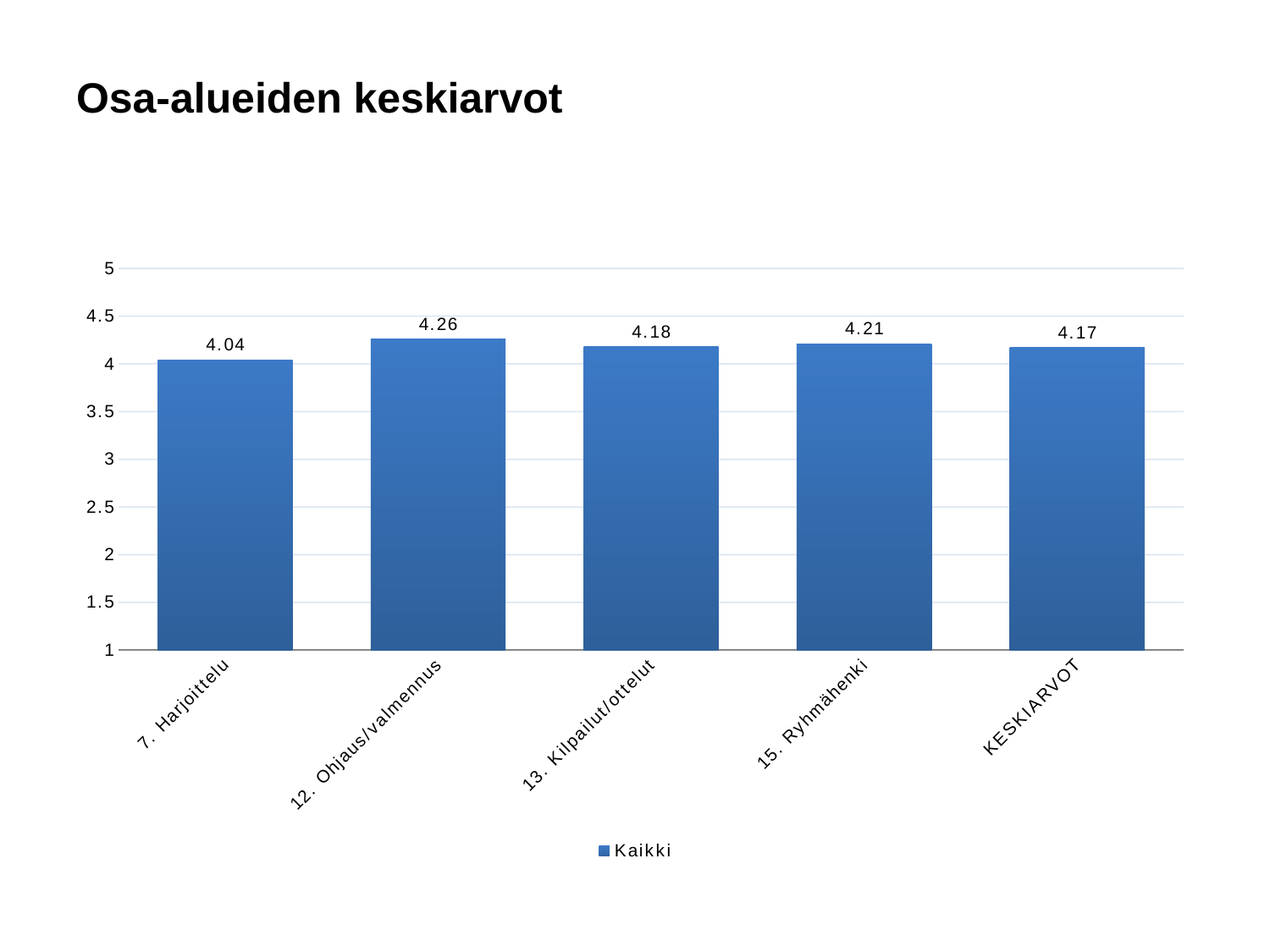
How many series does the legend list? 1 What is the value for KESKIARVOT? 4.17 Which category has the lowest value? 7. Harjoittelu What is the value for 15. Ryhmähenki? 4.21 What is the value for 13. Kilpailut/ottelut? 4.18 How many categories are shown on the x axis? 5 What type of chart is shown on the slide? Bar chart What is the value for 7. Harjoittelu? 4.04 What is the value for 12. Ohjaus/valmennus? 4.26 Which is larger, the value for 15. Ryhmähenki or the value for 7. Harjoittelu? 15. Ryhmähenki Which category has the highest value? 12. Ohjaus/valmennus What is the difference between the values for 12. Ohjaus/valmennus and 7. Harjoittelu? 0.22